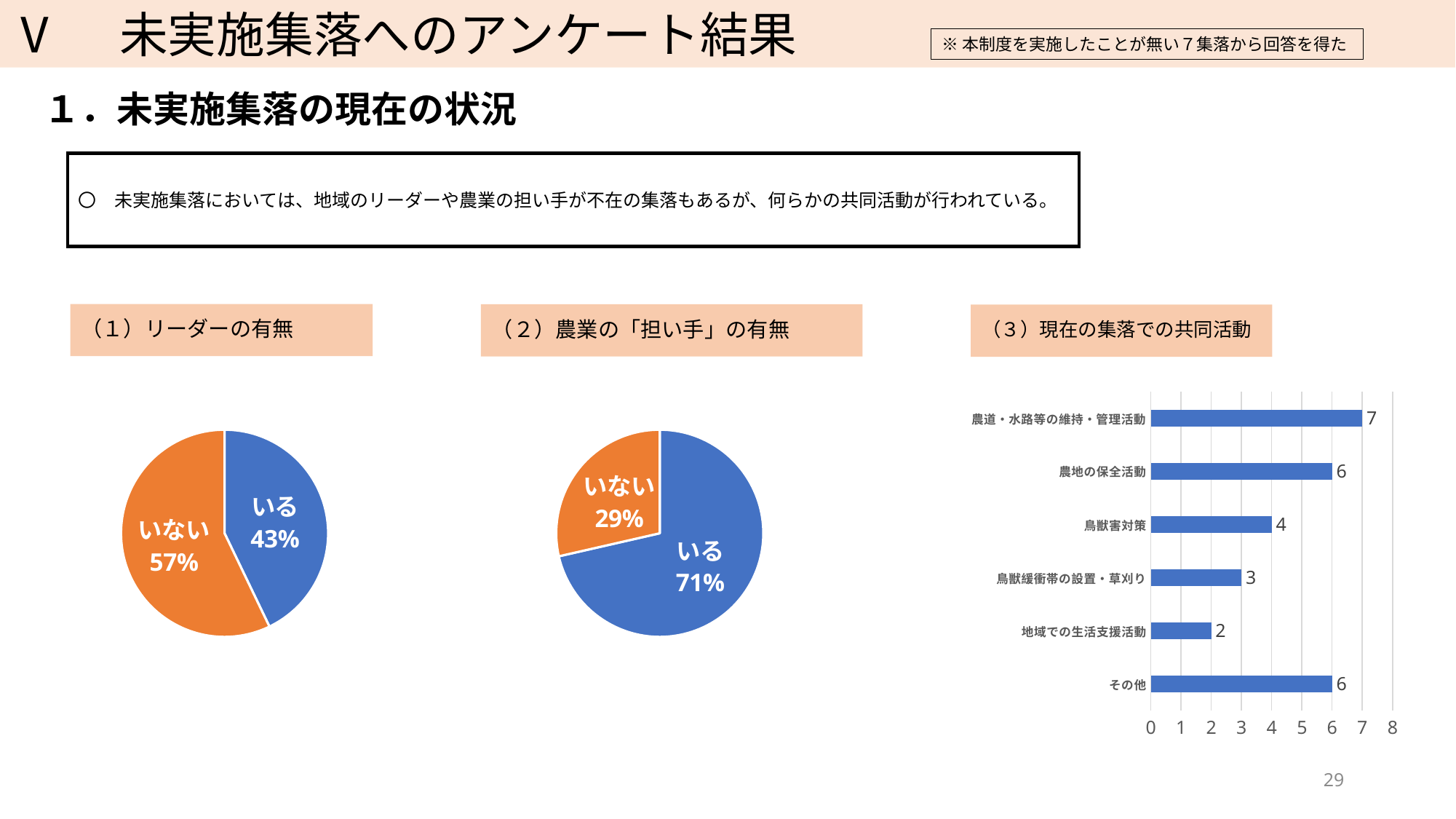
In the (3) 現在の集落での共同活動 bar chart, what is the difference between 鳥獣害対策 and 鳥獣緩衝帯の設置・草刈り? 1 In the (2) 農業の「担い手」の有無 pie chart, what is the difference between the いる and いない shares? 42% In the (2) 農業の「担い手」の有無 pie chart, what share is labelled いない? 29% In the (1) リーダーの有無 pie chart, which slice is larger, いる or いない? いない In the (2) 農業の「担い手」の有無 pie chart, what share is labelled いる? 71% In the (1) リーダーの有無 pie chart, what share is labelled いる? 43% In the (3) 現在の集落での共同活動 bar chart, which category has the highest value? 農道・水路等の維持・管理活動 What kind of chart is used for (3) 現在の集落での共同活動? bar chart In the (3) 現在の集落での共同活動 bar chart, how many categories are shown? 6 In the (3) 現在の集落での共同活動 bar chart, which category has the lowest value? 地域での生活支援活動 In the (1) リーダーの有無 pie chart, what share is labelled いない? 57% In the (3) 現在の集落での共同活動 bar chart, what is the value for 農道・水路等の維持・管理活動? 7